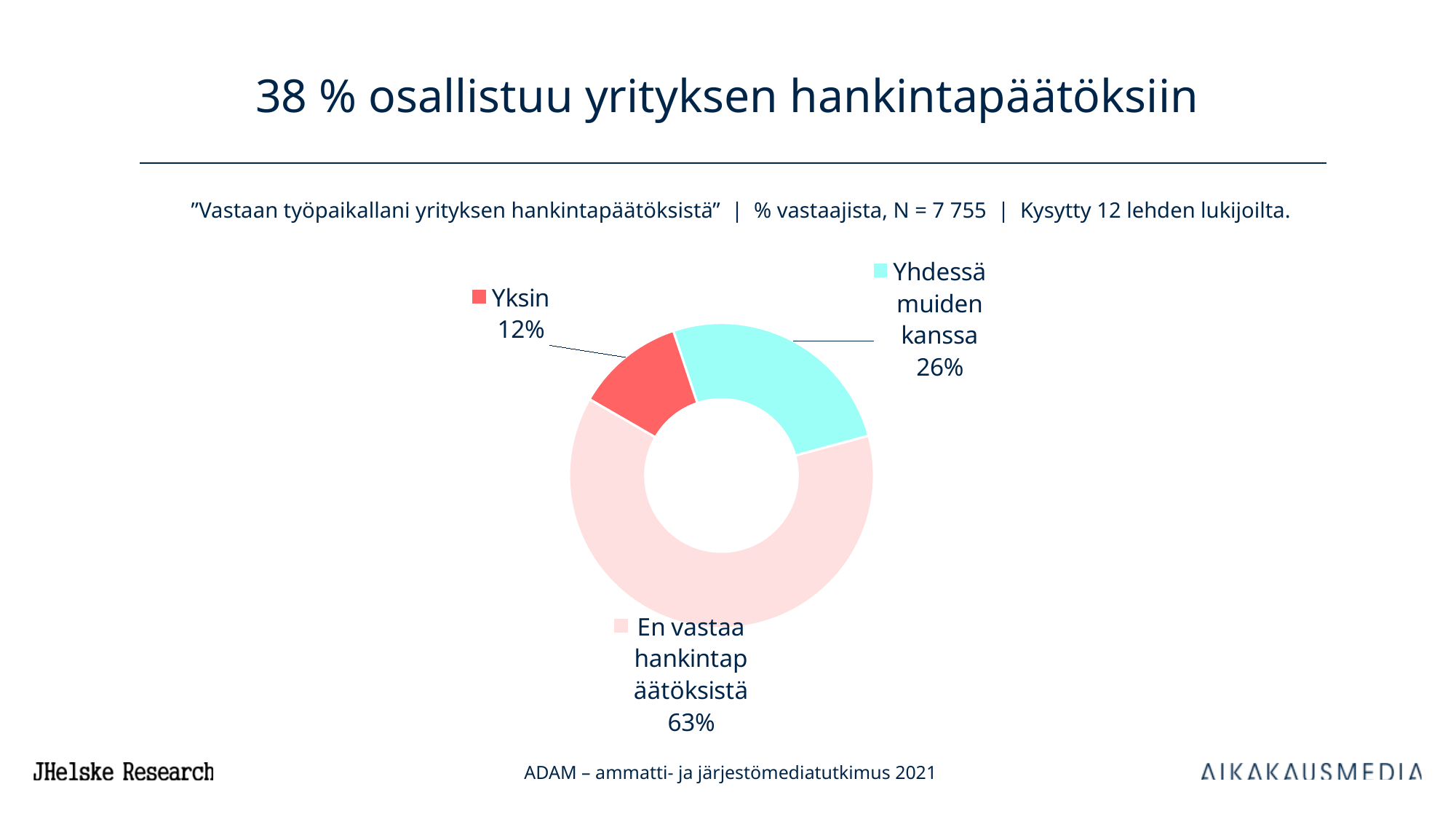
What percentage is shown for "Yksin"? 12% Which category has the largest share of the chart? En vastaa hankintapäätöksistä What is the title of the slide? 38 % osallistuu yrityksen hankintapäätöksiin Which is larger, the share for "Yksin" or the share for "Yhdessä muiden kanssa"? Yhdessä muiden kanssa What is the difference in percentage points between "En vastaa hankintapäätöksistä" and "Yhdessä muiden kanssa"? 37 What percentage is shown for "Yhdessä muiden kanssa"? 26% What colour is the "Yksin" slice? Red What is the difference in percentage points between "Yhdessä muiden kanssa" and "Yksin"? 14 How many categories (slices) does the chart have? 3 What percentage is shown for "En vastaa hankintapäätöksistä"? 63% What kind of chart is shown on the slide? Pie chart (doughnut) Which category has the smallest share of the chart? Yksin